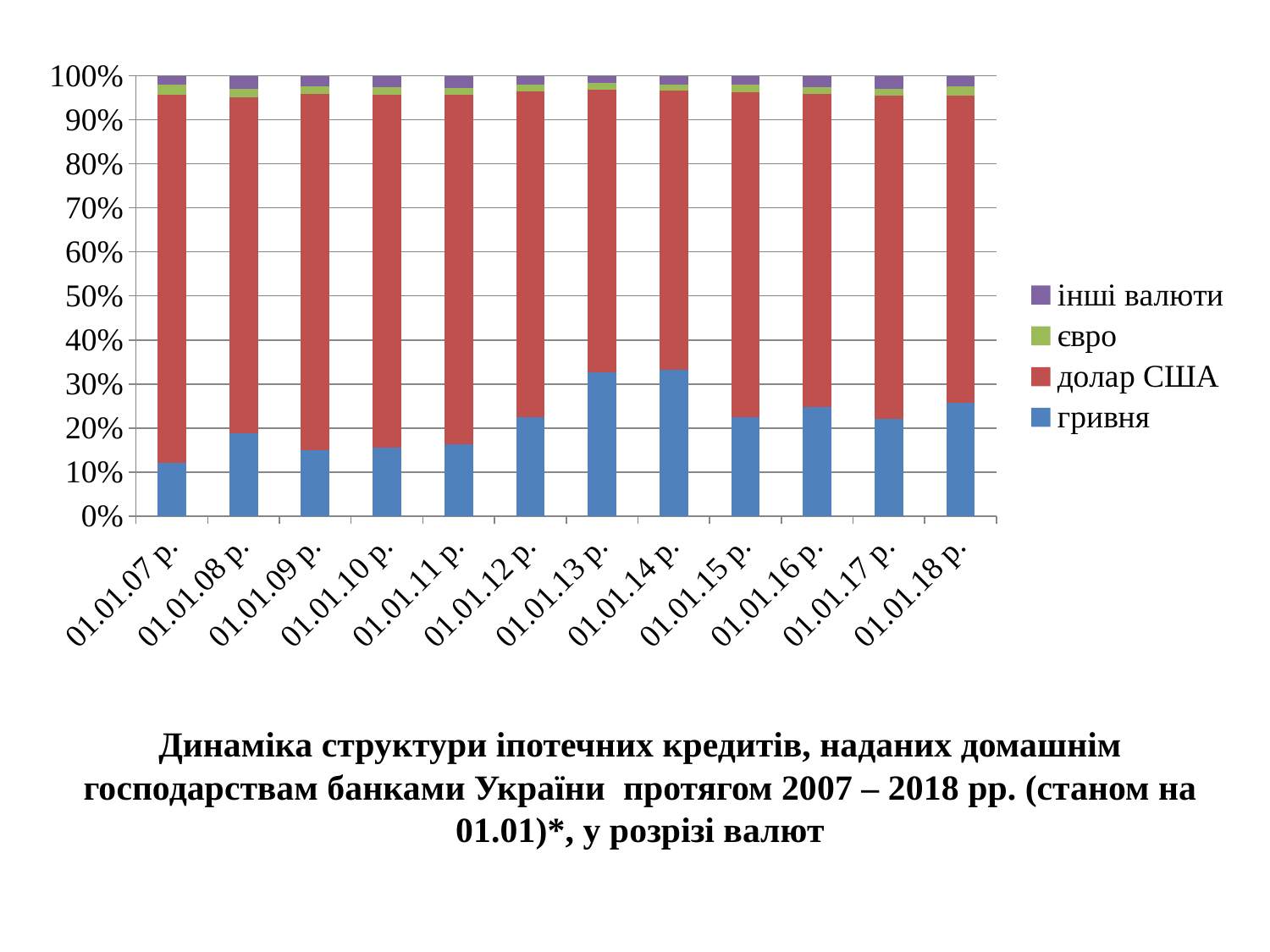
What kind of chart is shown on the slide? stacked bar chart Is the share of гривня for 01.01.13 р. greater or less than 30%? greater Is the share of гривня for 01.01.07 р. greater or less than 20%? less Which date has a larger share of гривня: 01.01.12 р. or 01.01.09 р.? 01.01.12 р. Which colour represents the series гривня in the chart? blue Is the share of гривня for 01.01.08 р. greater or less than 30%? less How many series does the legend list? 4 Which date has a larger share of гривня: 01.01.13 р. or 01.01.07 р.? 01.01.13 р. How many dates (categories) are shown along the x axis? 12 Which series occupies the largest share of the bar for 01.01.07 р.? долар США On which date is the share of гривня the lowest? 01.01.07 р.